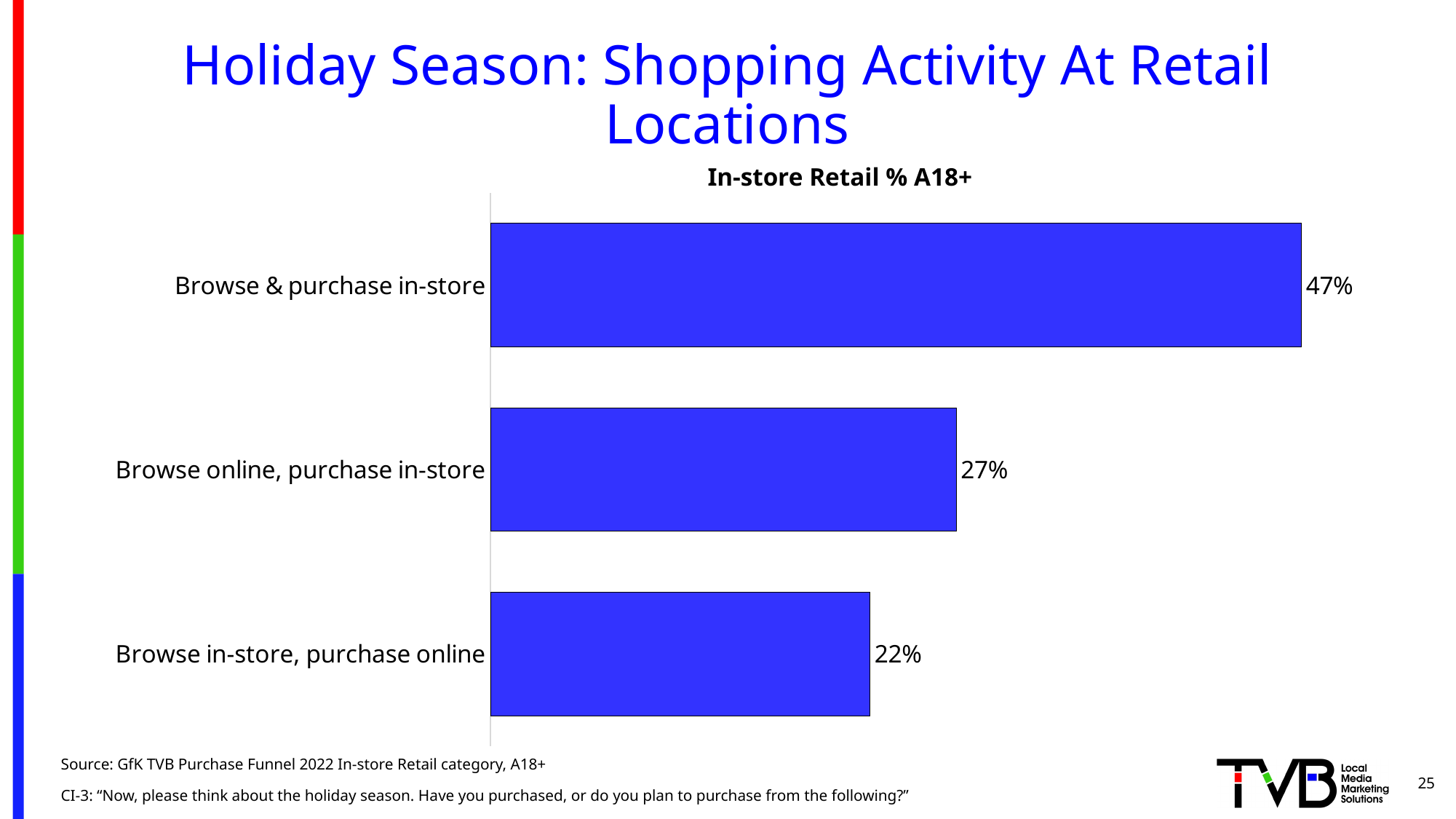
What colour are the bars in the chart? Blue What is the value for Browse & purchase in-store? 47% What kind of chart is shown on the slide? Bar chart What is the difference between the values for Browse & purchase in-store and Browse online, purchase in-store? 20% What is the difference between the values for Browse online, purchase in-store and Browse in-store, purchase online? 5% What is the value for Browse in-store, purchase online? 22% Which is larger: the value for Browse online, purchase in-store or the value for Browse in-store, purchase online? Browse online, purchase in-store Which category has the highest value? Browse & purchase in-store What is the value for Browse online, purchase in-store? 27% What is the title of the chart? In-store Retail % A18+ How many categories are shown in the chart? 3 Which category has the lowest value? Browse in-store, purchase online